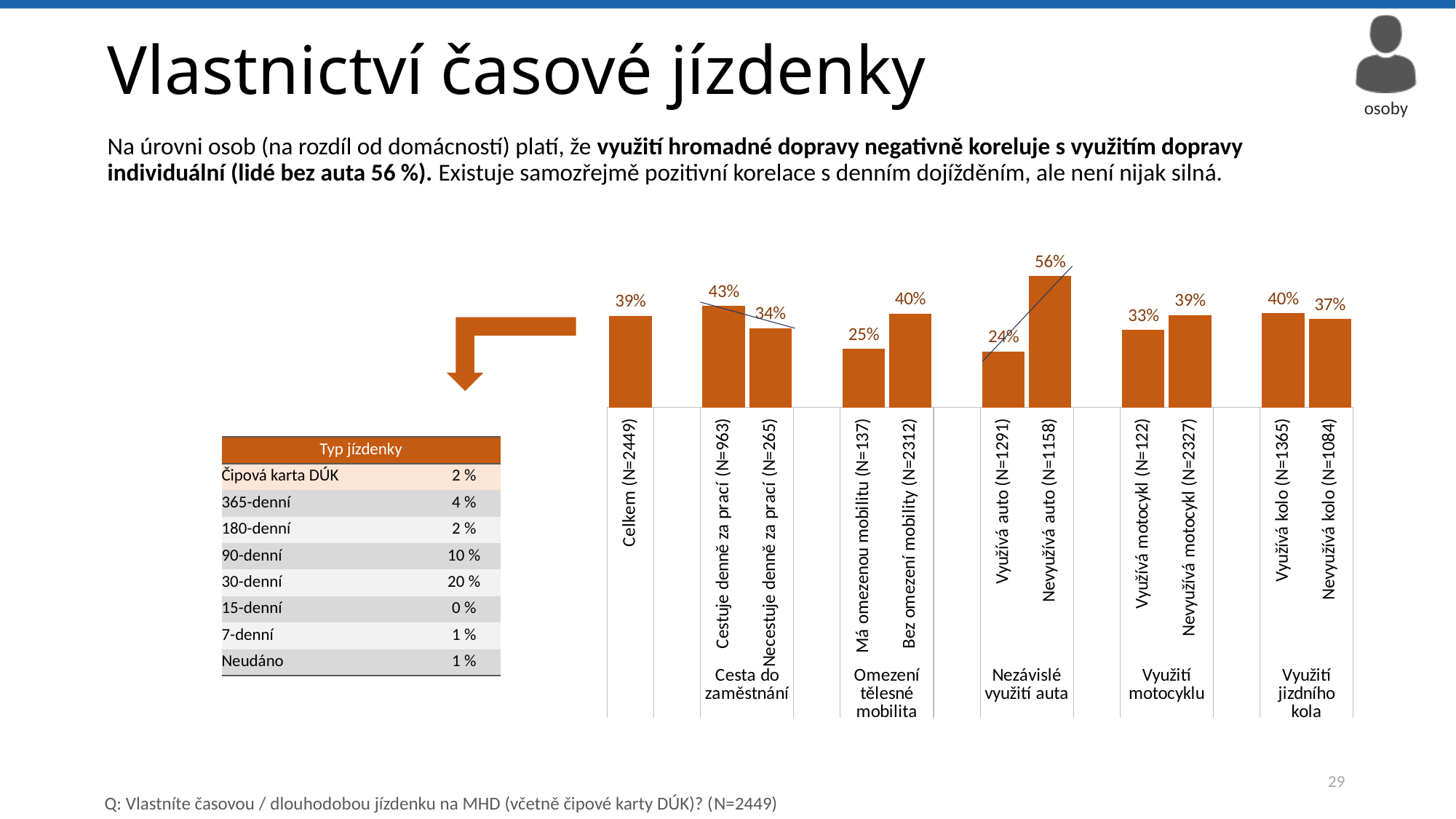
Which category has the lowest value? Využívá auto (N=1291) What is the difference between the values for Nevyužívá auto (N=1158) and Využívá auto (N=1291)? 32 percentage points What is the difference between the values for Cestuje denně za prací (N=963) and Necestuje denně za prací (N=265)? 9 percentage points Which is larger, the value for Využívá kolo (N=1365) or Nevyužívá kolo (N=1084)? Využívá kolo (N=1365) How many bars are plotted in the chart? 11 What is the value for Využívá motocykl (N=122)? 33% What is the value for Celkem (N=2449)? 39% Which category has the highest value? Nevyužívá auto (N=1158) What is the value for Nevyužívá auto (N=1158)? 56% What is the value for Má omezenou mobilitu (N=137)? 25% What colour are the bars in the chart? orange What kind of chart is shown on the slide? bar chart